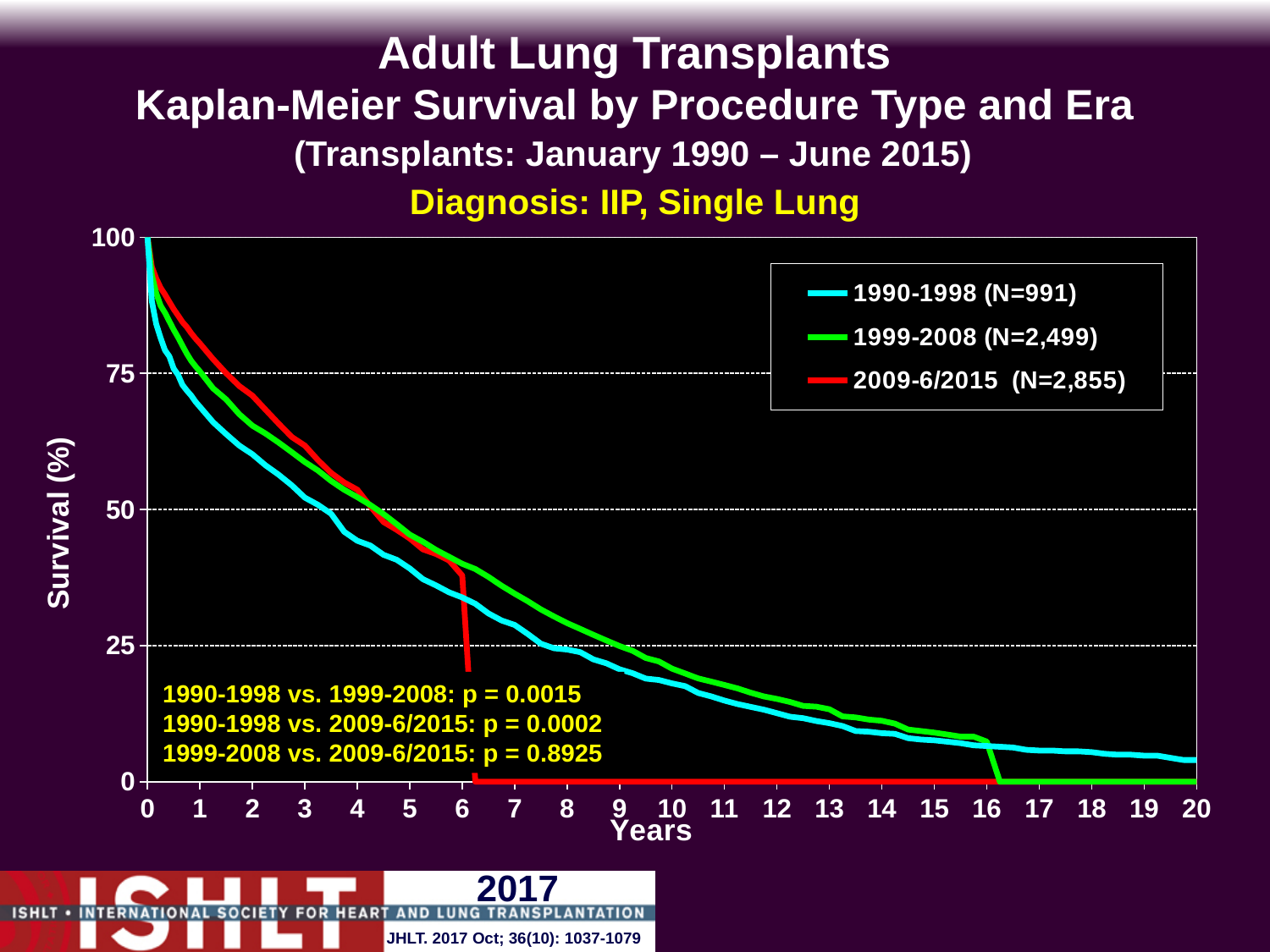
What is the N for the 1999-2008 era shown in the legend? N=2,499 Is the survival for the 1990-1998 era at 10 years greater or less than 25? less Do the survival curves rise or fall as years increase along the x axis? fall What is the p-value printed for 1999-2008 vs. 2009-6/2015? p = 0.8925 What colour is the line for the 1990-1998 era? cyan How many series does the legend list? 3 At 8 years, which era has higher survival, 1990-1998 or 1999-2008? 1999-2008 What is the p-value printed for 1990-1998 vs. 1999-2008? p = 0.0015 What kind of chart is shown on the slide? line chart What is the N for the 2009-6/2015 era shown in the legend? N=2,855 At 2 years, which era has the highest survival? 2009-6/2015 Is the survival for the 2009-6/2015 era at 1 year greater or less than 75? greater